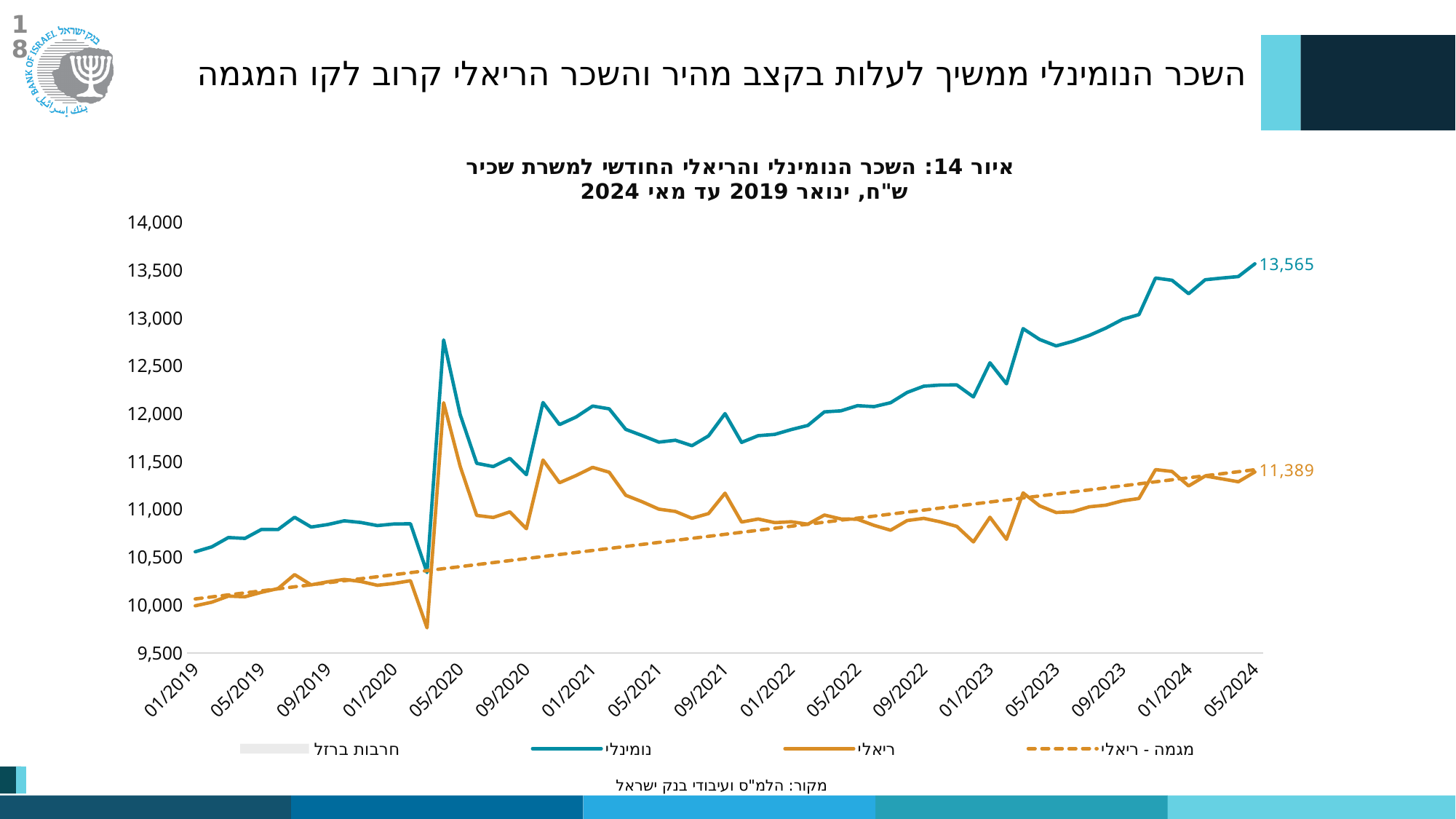
Which series is drawn as a dashed line? מגמה - ריאלי What type of chart is shown on the slide? line chart At 05/2024, which series has the larger value, נומינלי or ריאלי? נומינלי Does the נומינלי series generally rise or fall from 01/2019 to 05/2024? rise Is the lowest value of the ריאלי series (the dip in early 2020) greater or less than 10,000? less Is the value of the נומינלי series at 01/2019 greater or less than 11,000? less What is the value of the ריאלי (real) series at 05/2024? 11,389 Is the peak value of the נומינלי series around 05/2020 greater or less than 12,500? greater What is the difference between the נומינלי and ריאלי values at 05/2024? 2,176 What is the value of the נומינלי (nominal) series at 05/2024? 13,565 How many series does the legend list? 4